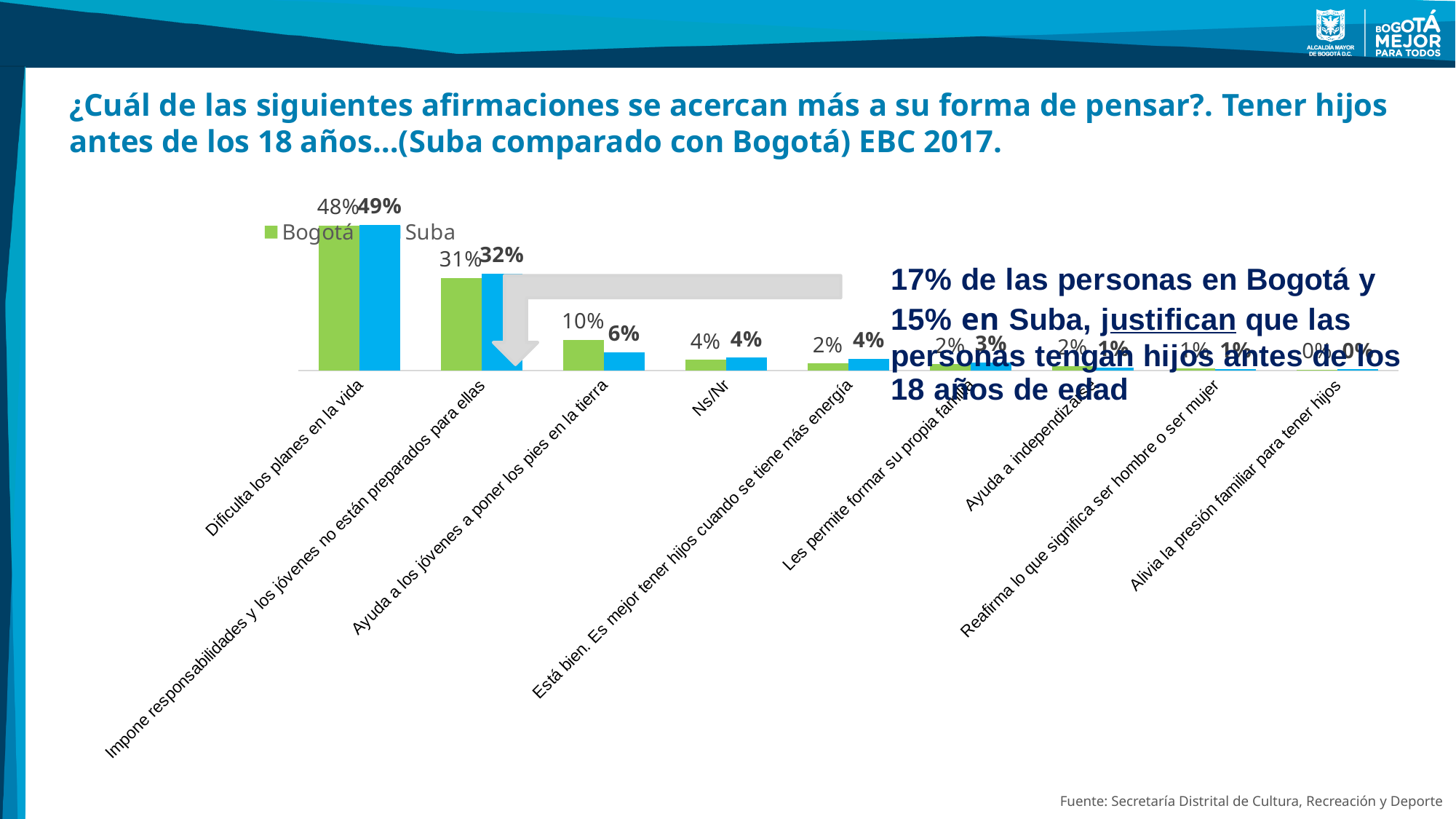
What is the Bogotá value for "Ayuda a los jóvenes a poner los pies en la tierra"? 10% What is the Bogotá value for "Dificulta los planes en la vida"? 48% What is the difference between the Bogotá and Suba values for "Ayuda a los jóvenes a poner los pies en la tierra"? 4% For "Está bien. Es mejor tener hijos cuando se tiene más energía", which is larger, the Bogotá value or the Suba value? Suba Which colour represents the Suba series in the chart? blue How many series does the legend list? 2 What type of chart is shown on the slide? bar chart Which category has the lowest Bogotá value? Alivia la presión familiar para tener hijos Which category has the highest Suba value? Dificulta los planes en la vida How many categories are shown on the x axis of the chart? 9 What is the Suba value for "Dificulta los planes en la vida"? 49% What is the Suba value for "Impone responsabilidades y los jóvenes no están preparados para ellas"? 32%